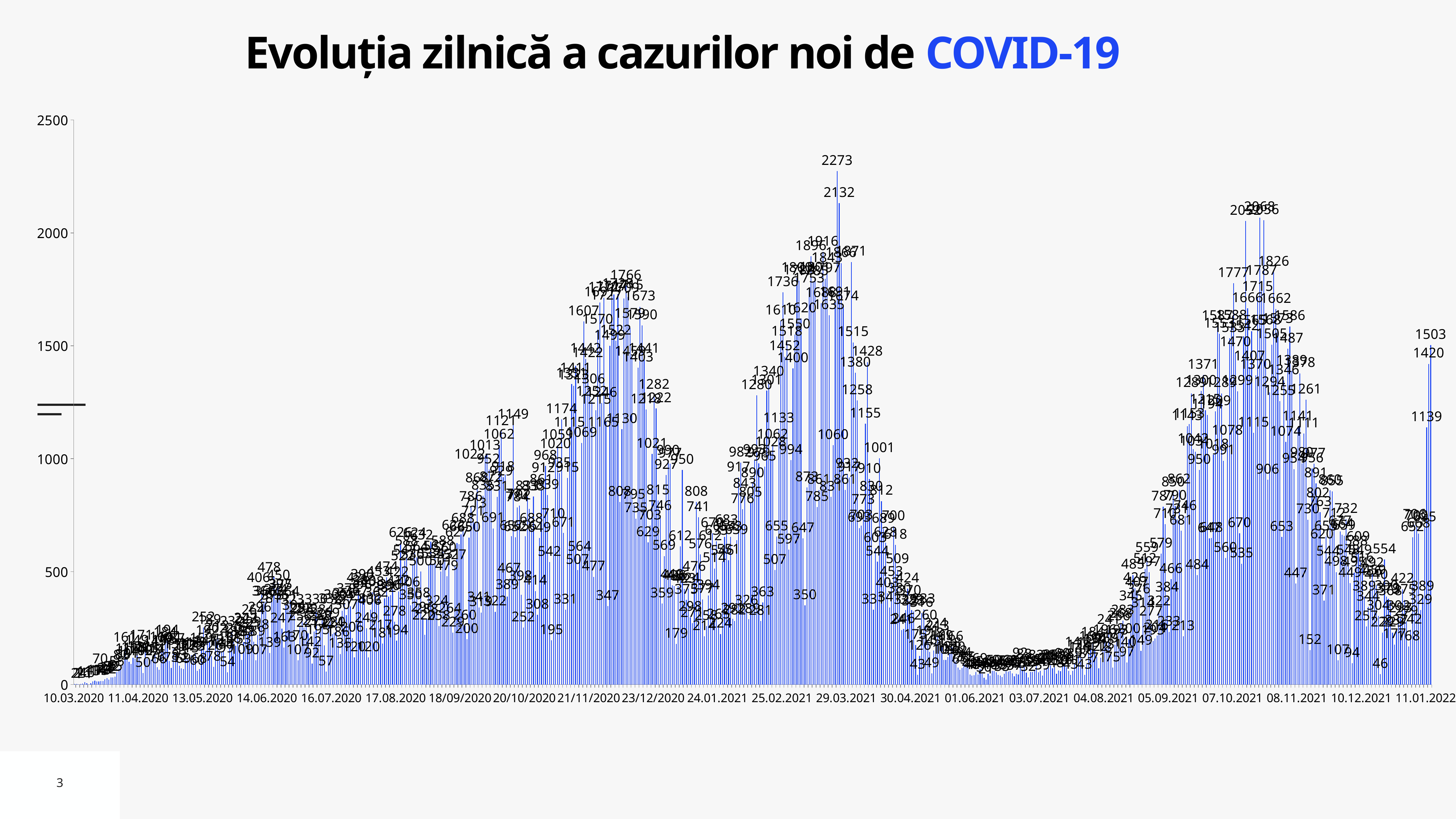
What is the topmost value shown on the vertical axis? 2500 Between 04.08.2021 and 07.10.2021, do the daily values rise or fall? rise Between 30.04.2021 and 01.06.2021, do the daily values rise or fall? fall What is the title of the chart? Evoluția zilnică a cazurilor noi de COVID-19 Is the highest bar on the chart greater or less than 2000? greater What is the highest value labelled near 11.01.2022 at the right end of the chart? 1503 Are the bars around 01.06.2021 greater or less than 500? less What kind of chart is shown on the slide? bar chart Is the bar labelled 2132 greater or less than 2000? greater Which peak is higher: the one near 29.03.2021 or the one near 07.10.2021? 29.03.2021 What is the highest daily value labelled on the chart? 2273 What is the difference between the two highest labelled values, 2273 and 2132? 141